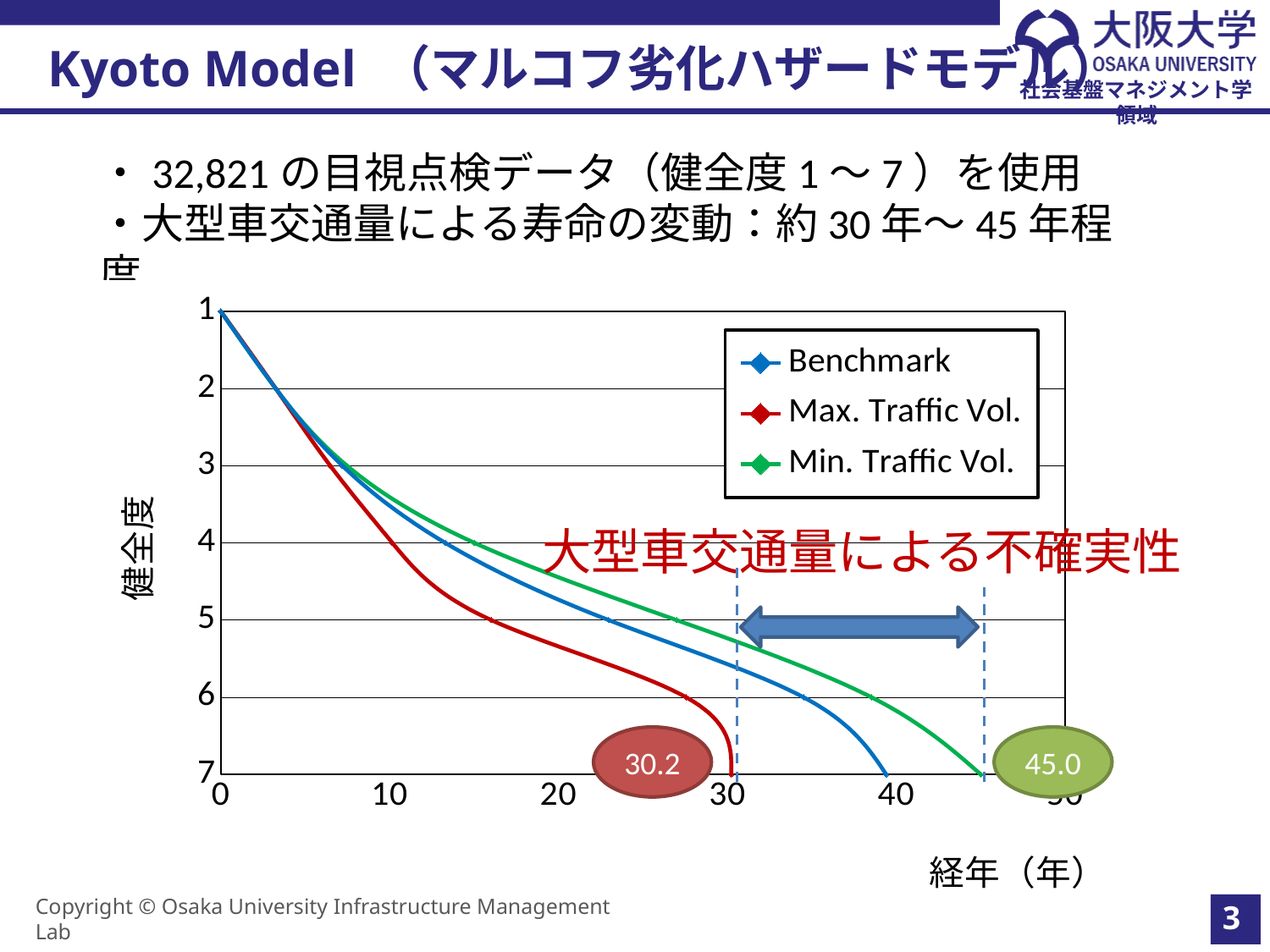
Is the age at which the Benchmark curve reaches health level 7 greater or less than 30 years? greater How many series does the chart legend list? 3 What kind of chart is shown on the slide? line chart At what age (years) does the Min. Traffic Vol. curve reach health level 7, according to the printed label? 45.0 What is the difference in years between the labelled end points of the Min. Traffic Vol. curve (45.0) and the Max. Traffic Vol. curve (30.2)? 14.8 Which curve reaches health level 7 at an earlier age, Max. Traffic Vol. or Min. Traffic Vol.? Max. Traffic Vol. As age (経年) increases along the x axis, do the health level (健全度) values of the curves rise or fall? rise At age 10 years, is the health level value of the Min. Traffic Vol. curve greater or less than 3? greater Which series reaches health level 7 at the greatest age? Min. Traffic Vol. What colour is the Max. Traffic Vol. line in the chart? red What are the three series named in the chart legend? Benchmark, Max. Traffic Vol., Min. Traffic Vol. At what age (years) does the Max. Traffic Vol. curve reach health level 7, according to the printed label? 30.2